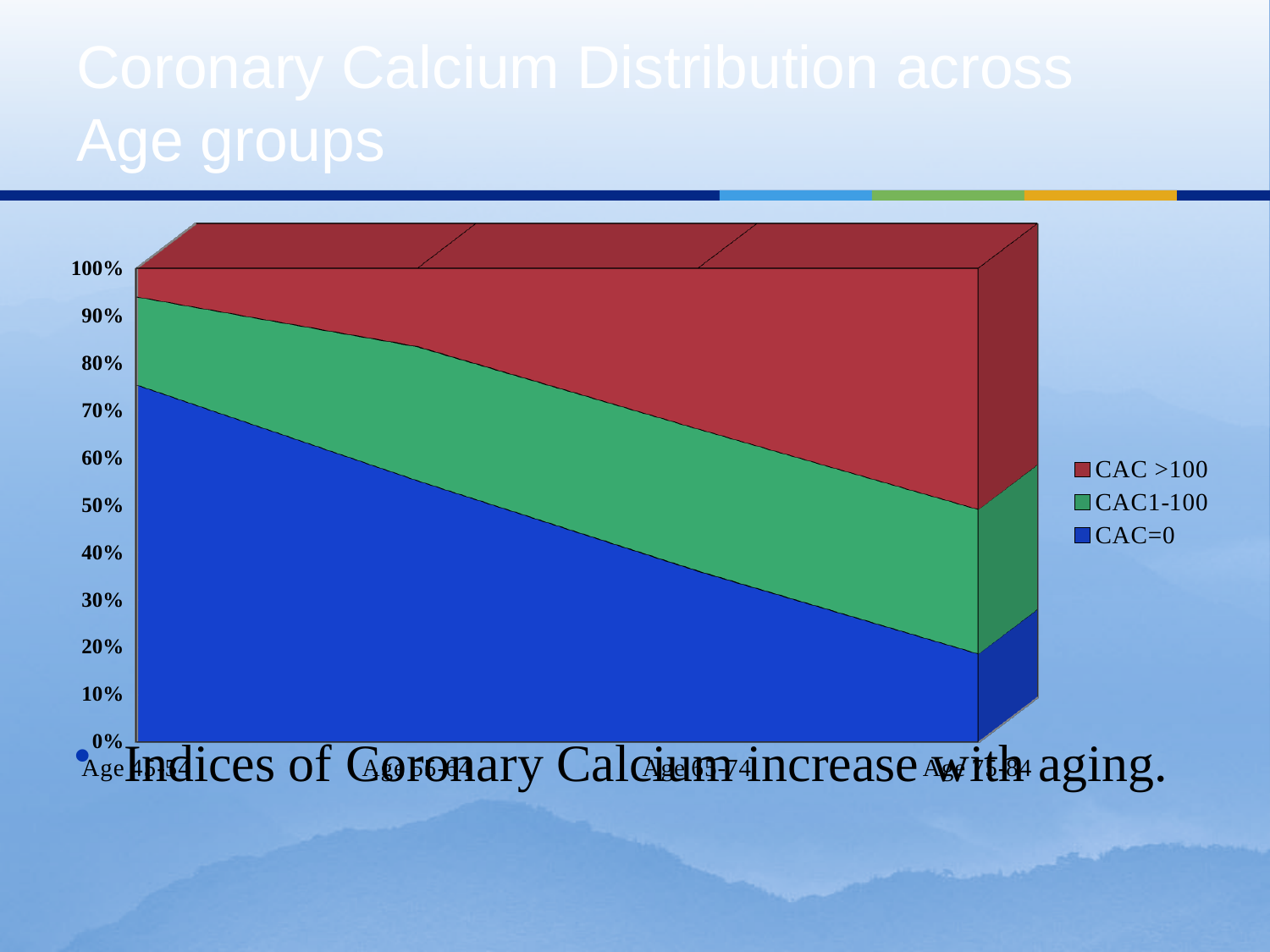
Which colour represents the CAC=0 series in the legend? Blue Does the share of CAC=0 rise or fall as age increases along the x axis? Fall How many series does the legend list? 3 Is the share of CAC=0 larger for Age 45-54 or for Age 75-84? Age 45-54 Is the share of CAC=0 for Age 75-84 greater or less than 30%? less How many age groups are shown along the x axis? 4 What kind of chart is shown on the slide? Stacked area chart Is the share of CAC=0 for Age 45-54 greater or less than 70%? greater Which age group has the lowest share of CAC=0? Age 75-84 Which age group has the highest share of CAC=0? Age 45-54 Is the share of CAC >100 for Age 45-54 greater or less than 10%? less What is the title of the slide containing the chart? Coronary Calcium Distribution across Age groups